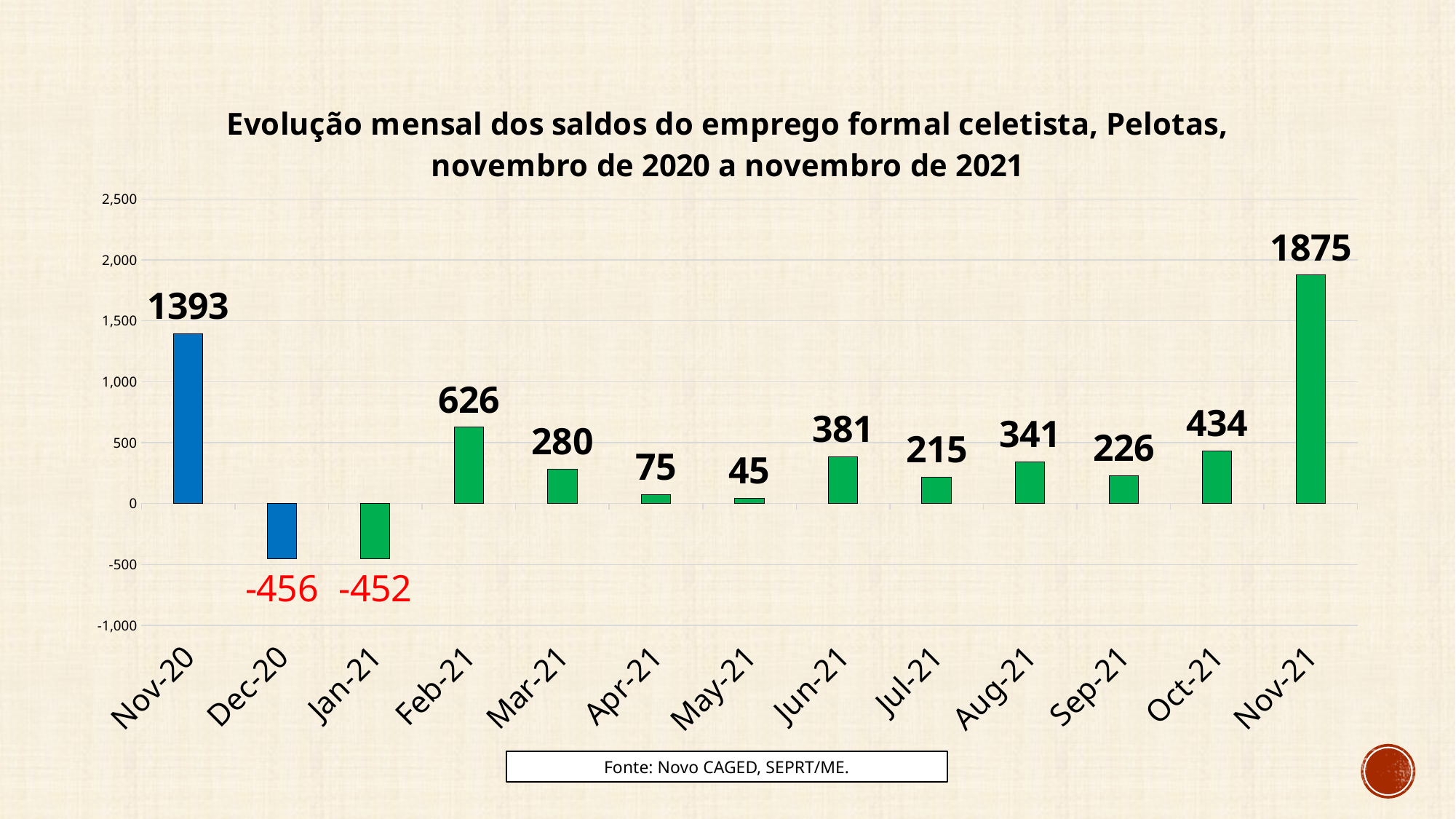
Which is larger, the value for Oct-21 or the value for Aug-21? Oct-21 What is the difference between the values for Nov-21 and Nov-20? 482 What is the value for Dec-20? -456 Is the value for Nov-20 greater or less than 1,000? greater Which month has the highest value? Nov-21 What is the difference between the values for Feb-21 and Mar-21? 346 Which month has the lowest value? Dec-20 What is the value for Nov-21? 1875 How many months are shown on the x axis? 13 What source is cited below the chart? Novo CAGED, SEPRT/ME. What kind of chart is shown on the slide? bar chart What is the value for Jun-21? 381